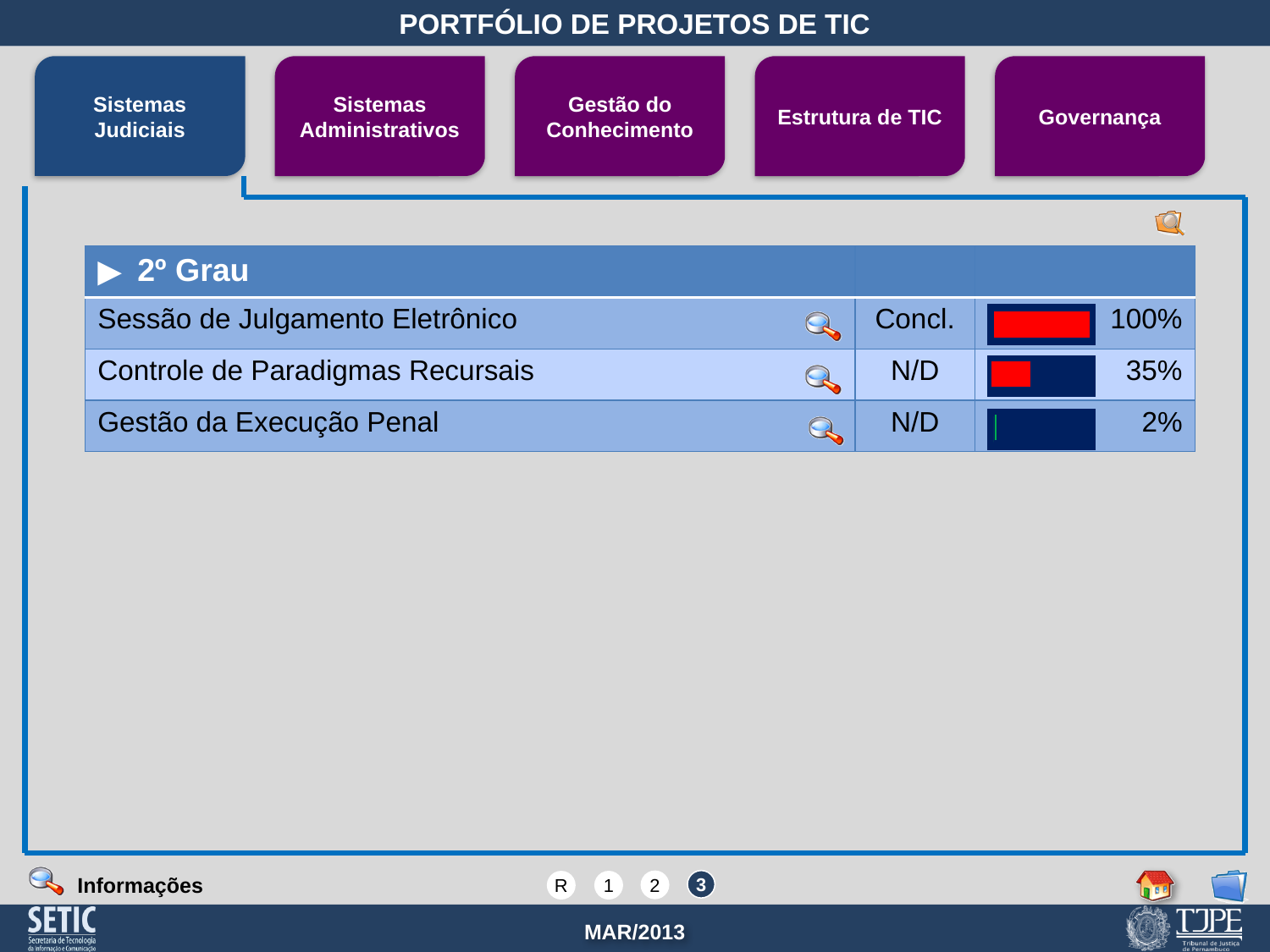
Which project under 2º Grau has the highest completion percentage? Sessão de Julgamento Eletrônico What status is shown for Gestão da Execução Penal? N/D What is the completion percentage shown for Sessão de Julgamento Eletrônico? 100% What kind of chart is used to show the completion percentages in the table? bar chart What status is shown for Sessão de Julgamento Eletrônico? Concl. What is the difference in completion percentage between Controle de Paradigmas Recursais and Gestão da Execução Penal? 33% What is the completion percentage shown for Controle de Paradigmas Recursais? 35% What is the difference in completion percentage between Sessão de Julgamento Eletrônico and Controle de Paradigmas Recursais? 65% How many projects are listed under 2º Grau? 3 What is the completion percentage shown for Gestão da Execução Penal? 2% Which project under 2º Grau has the lowest completion percentage? Gestão da Execução Penal Which has a higher completion percentage, Controle de Paradigmas Recursais or Gestão da Execução Penal? Controle de Paradigmas Recursais